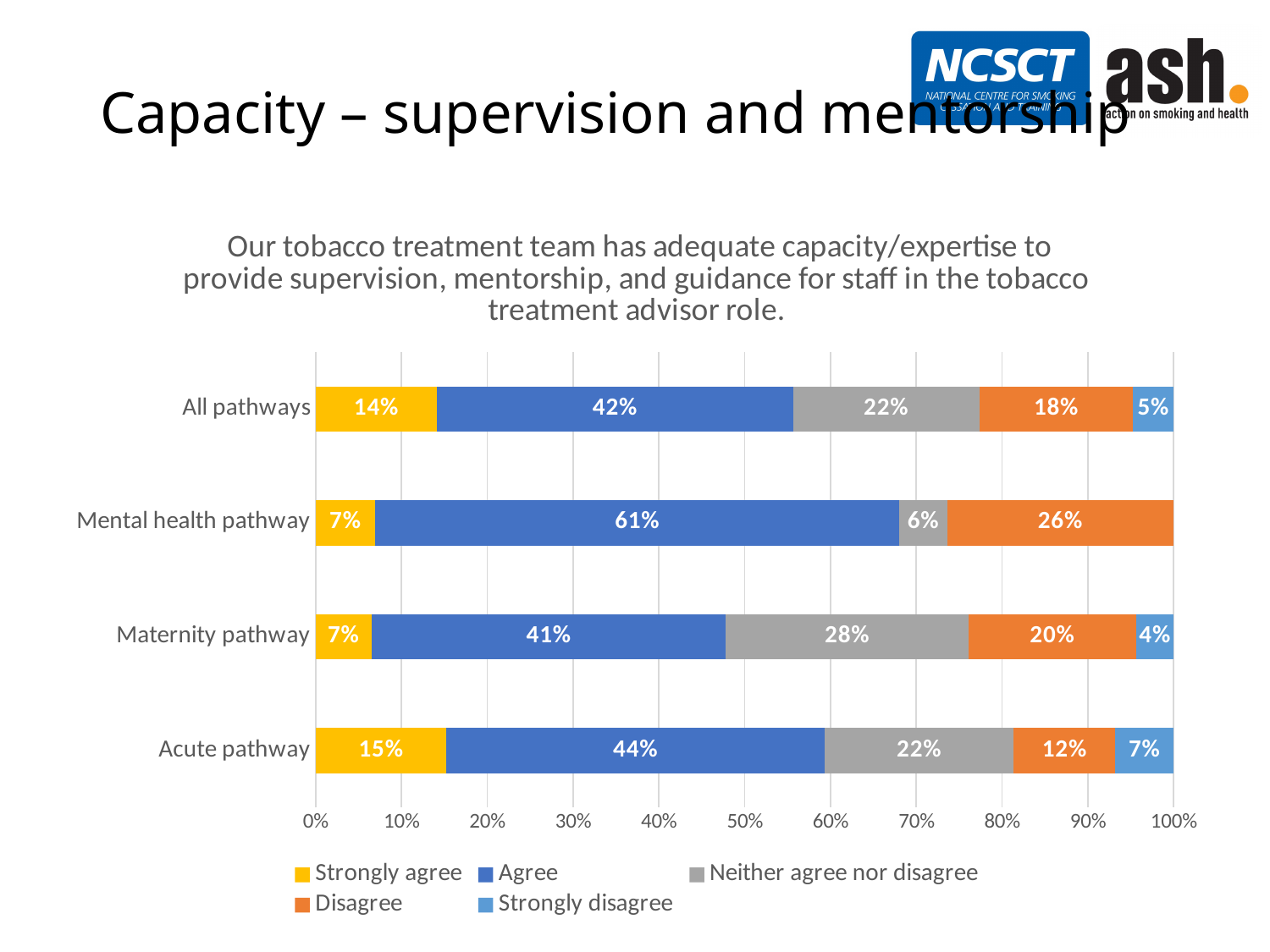
What is the difference between the Agree values for the Mental health pathway and the Maternity pathway? 20% Which is larger: the Strongly disagree value for the Acute pathway or for the Maternity pathway? Acute pathway How many pathway categories are shown on the chart? 4 What is the Neither agree nor disagree value for the Maternity pathway? 28% What type of chart is shown on the slide? Stacked bar chart What is the Strongly agree value for the Acute pathway? 15% What percentage of the Mental health pathway respondents selected Agree? 61% Which pathway has the lowest Disagree percentage? Acute pathway How many series does the legend list? 5 Which colour represents the Disagree series in the chart? Orange Which pathway has the highest Agree percentage? Mental health pathway What is the Disagree value for All pathways? 18%